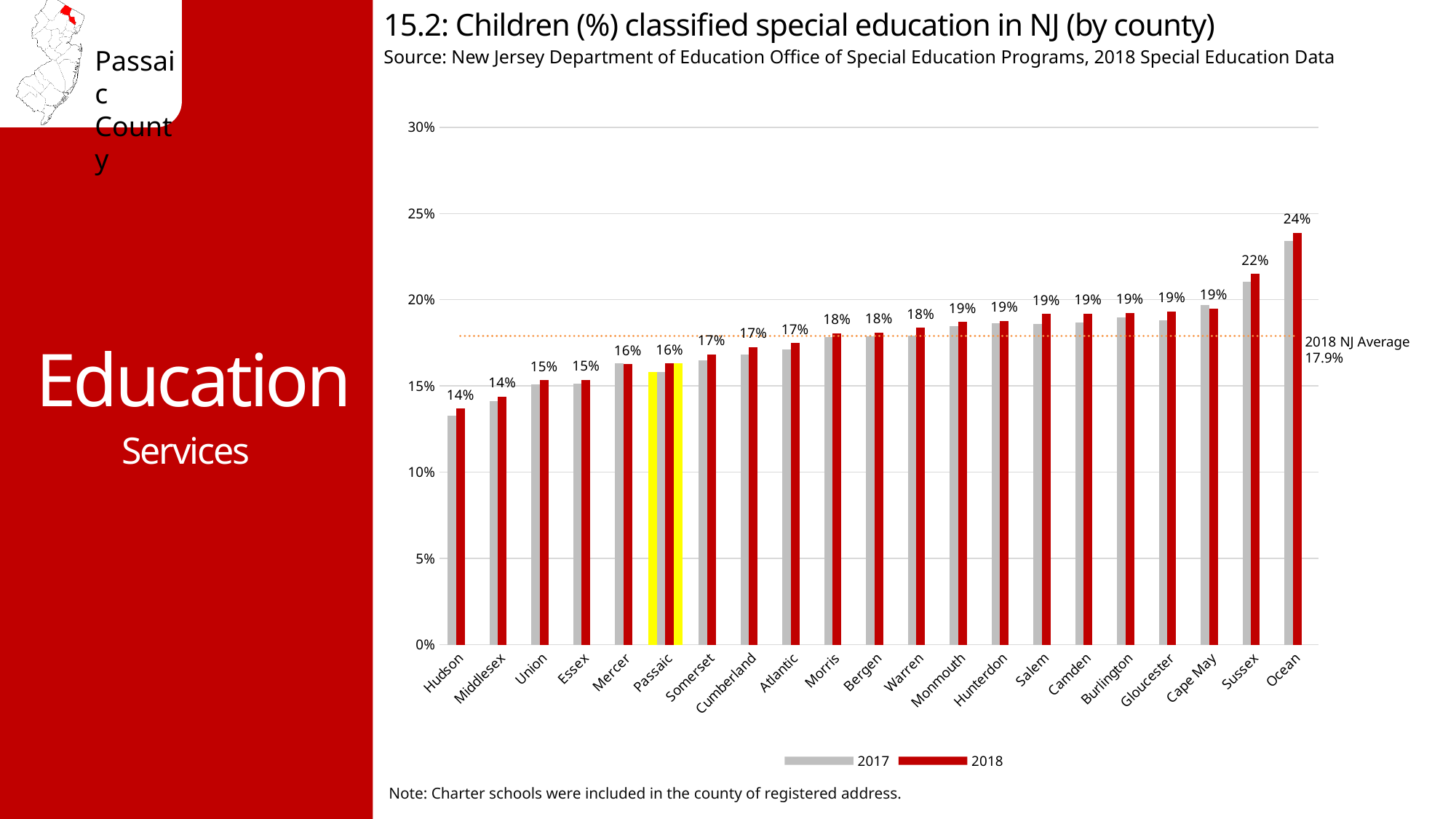
Which has a larger value, Sussex or Mercer? Sussex Which county has the highest value? Ocean What percentage is labelled for Sussex? 22% What is the 2018 NJ Average shown by the dotted line? 17.9% What kind of chart is shown on the slide? bar chart Is the 2018 value for Ocean greater or less than 20%? greater What is the difference between the labelled values for Ocean and Hudson? 10 percentage points How many counties are shown along the x axis? 21 What percentage is labelled for Passaic? 16% How many series does the legend list? 2 Which county has the lowest value? Hudson What percentage is labelled for Ocean? 24%